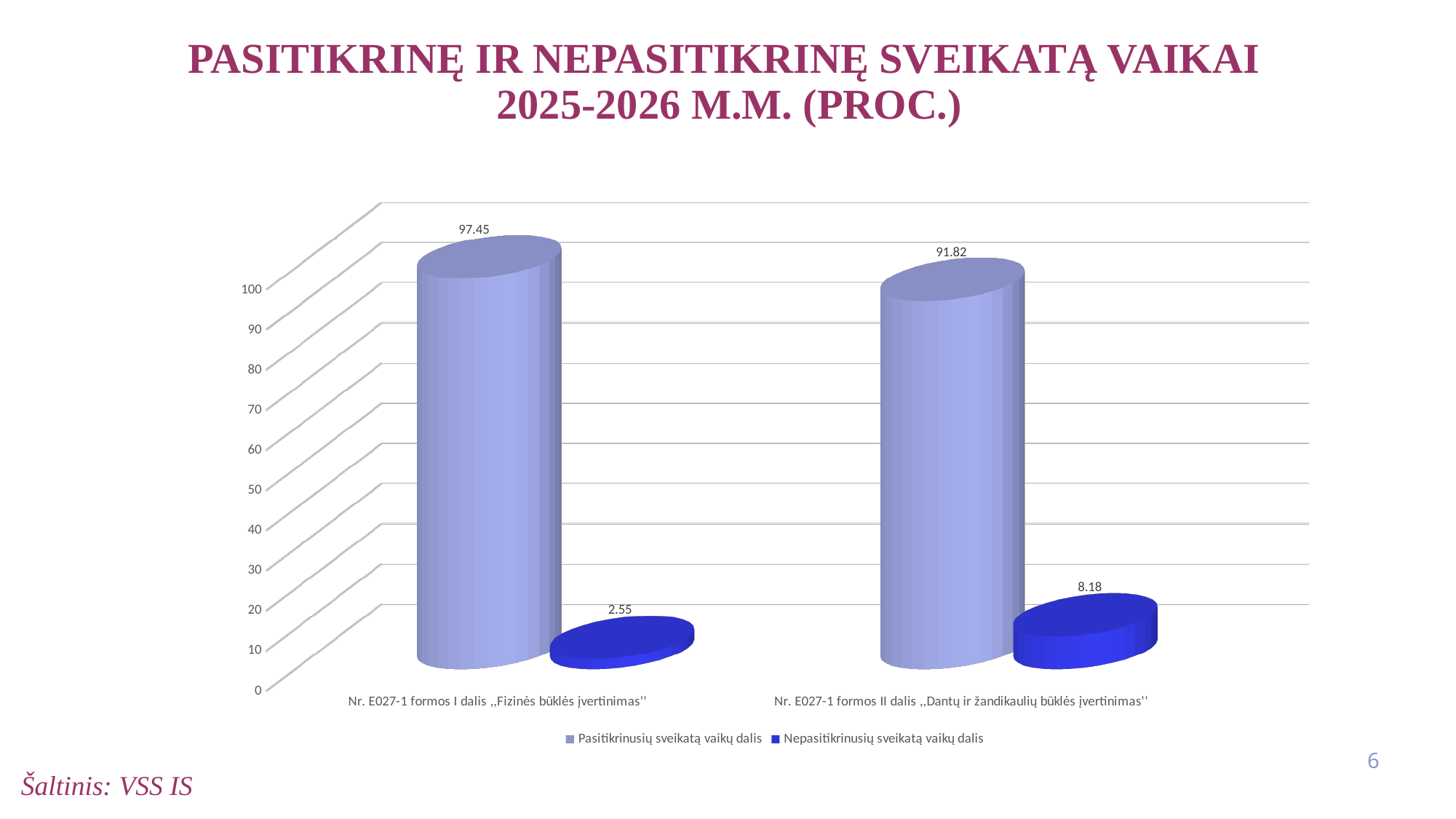
What is the value of 'Pasitikrinusių sveikatą vaikų dalis' for 'Nr. E027-1 formos I dalis ,,Fizinės būklės įvertinimas'''? 97.45 How many series does the legend list? 2 Which category has the lower value for 'Nepasitikrinusių sveikatą vaikų dalis'? Nr. E027-1 formos I dalis ,,Fizinės būklės įvertinimas'' What is the difference between the 'Nepasitikrinusių sveikatą vaikų dalis' values for the two categories? 5.63 What is the difference between the 'Pasitikrinusių sveikatą vaikų dalis' values for the two categories? 5.63 Which category has the higher value for 'Pasitikrinusių sveikatą vaikų dalis'? Nr. E027-1 formos I dalis ,,Fizinės būklės įvertinimas'' What is the value of 'Pasitikrinusių sveikatą vaikų dalis' for 'Nr. E027-1 formos II dalis ,,Dantų ir žandikaulių būklės įvertinimas'''? 91.82 Is the 'Nepasitikrinusių sveikatą vaikų dalis' value for 'Nr. E027-1 formos II dalis' larger or smaller than the same series for 'Nr. E027-1 formos I dalis'? larger What kind of chart is shown on the slide? bar chart How many categories are shown on the x axis? 2 What is the value of 'Nepasitikrinusių sveikatą vaikų dalis' for 'Nr. E027-1 formos II dalis ,,Dantų ir žandikaulių būklės įvertinimas'''? 8.18 What is the value of 'Nepasitikrinusių sveikatą vaikų dalis' for 'Nr. E027-1 formos I dalis ,,Fizinės būklės įvertinimas'''? 2.55